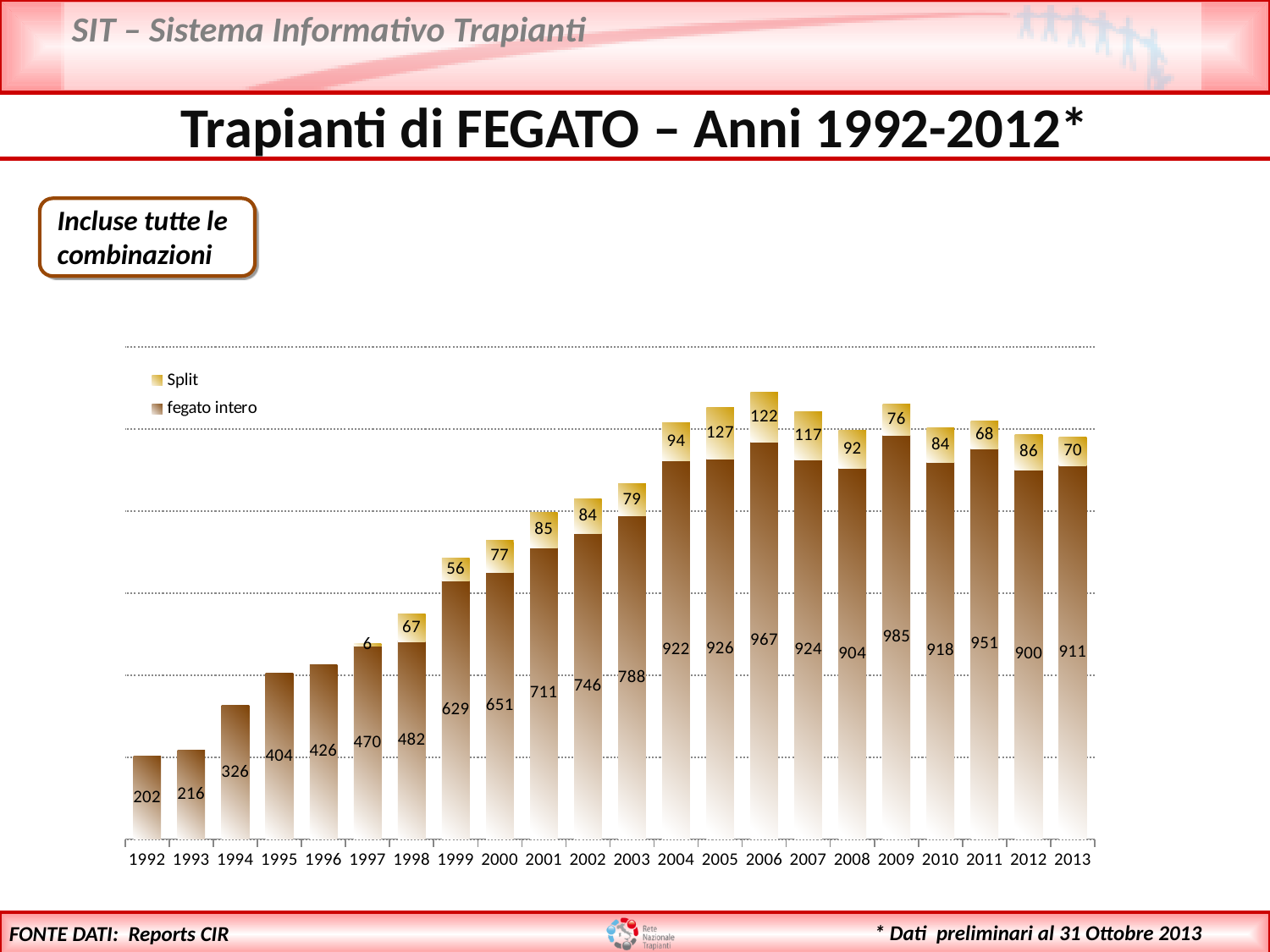
What is the value of fegato intero for 2006? 967 Which is larger, the fegato intero value for 2011 or for 2012? 2011 Which year has the highest fegato intero value? 2009 How many series does the legend list? 2 What kind of chart is shown on the slide? Stacked bar chart Which year has the lowest fegato intero value? 1992 How many years are shown on the x axis? 22 What is the difference between the fegato intero values for 2009 and 2013? 74 What is the total of the stacked bar for 2006 (fegato intero plus Split)? 1089 What is the Split value for 2005? 127 Which year has the highest Split value? 2005 What is the fegato intero value for 1992? 202